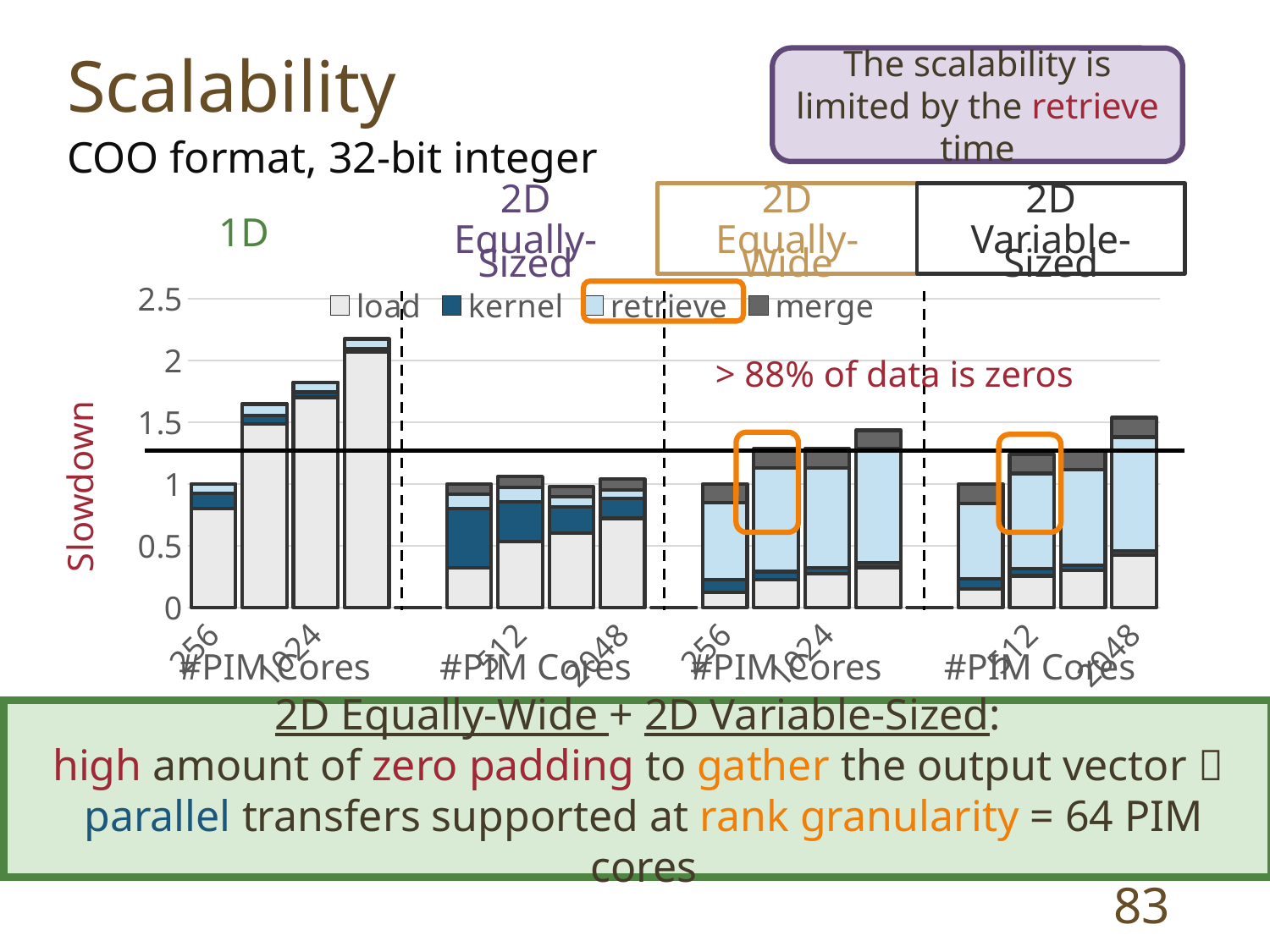
Which group contains the tallest stacked bar in the chart? 1D Is the total of the second bar in the 1D group greater or less than 1.5? greater How many series does the chart legend list? 4 What is the title of the vertical axis of the chart? Slowdown Is the total of the rightmost bar in the 2D Equally-Wide group greater or less than 1.5? less Is the total of the rightmost bar in the 1D group greater or less than 2? greater Do the stacked bar totals rise or fall from left to right within the 1D group? rise What are the four series named in the chart legend? load, kernel, retrieve, merge How many bars are plotted in the 1D group of the chart? 4 How many groups of bars (partitioning schemes) does the chart show? 4 What kind of chart is shown on the slide? stacked bar chart